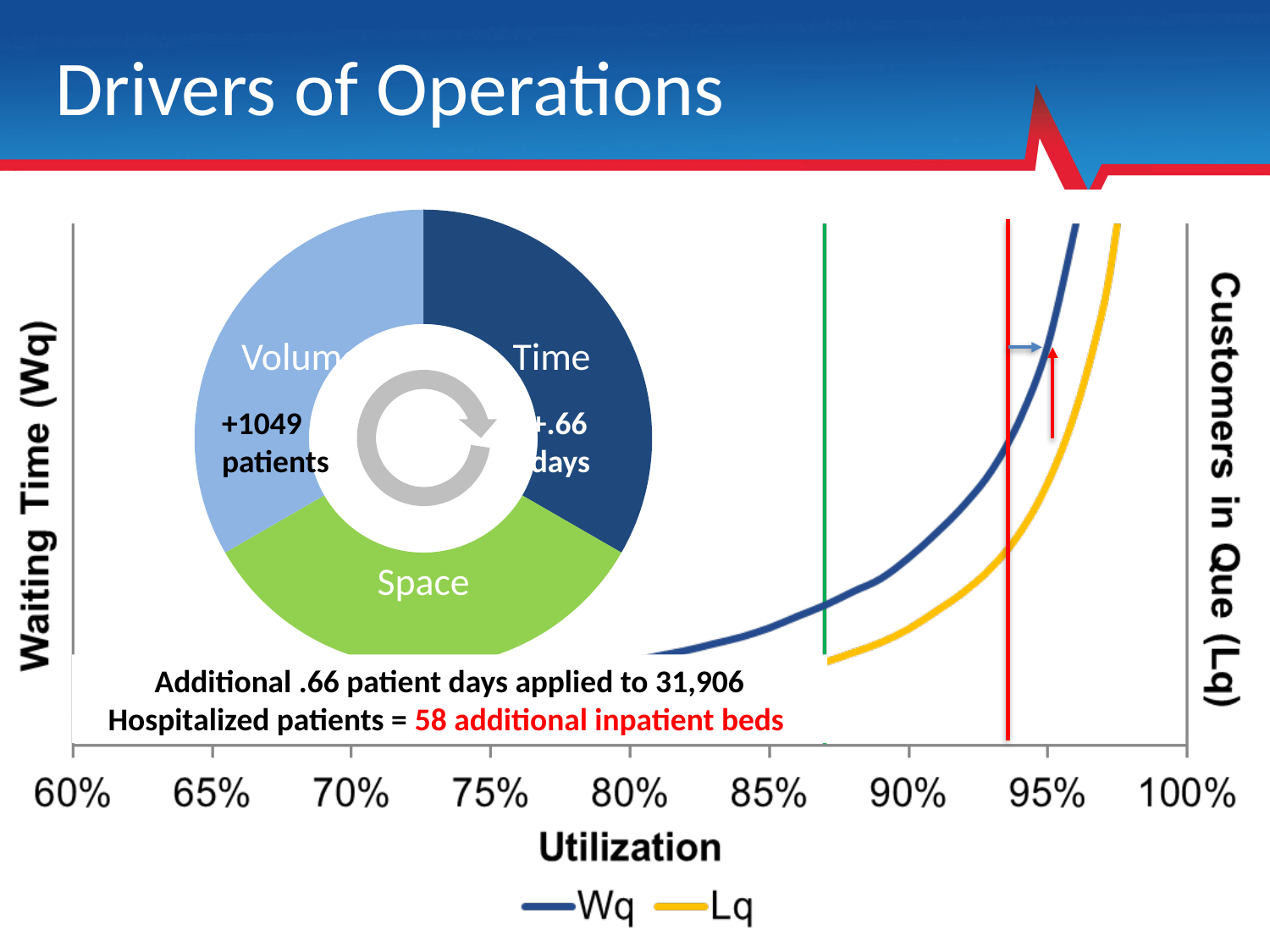
In the Volume/Time/Space chart, how many categories are there? 3 In the line chart with the Utilization axis, do the Wq and Lq lines rise or fall as utilization increases? rise What kind of chart is the chart on the right with the Utilization axis? line chart In the line chart with the Utilization axis, what is the title of the x axis? Utilization In the line chart with the Utilization axis, what is the highest utilization value shown on the x axis? 100% In the line chart with the Utilization axis, how many series does the legend list? 2 In the line chart with the Utilization axis, what are the two series named in the legend? Wq and Lq In the Volume/Time/Space chart, what value is printed for Volume? +1049 patients In the Volume/Time/Space chart, what colour is the Space slice? green In the line chart with the Utilization axis, what is the lowest utilization value shown on the x axis? 60% What kind of chart is the Volume/Time/Space chart on the left? pie chart (donut) In the Volume/Time/Space chart, what value is printed for Time? +.66 days